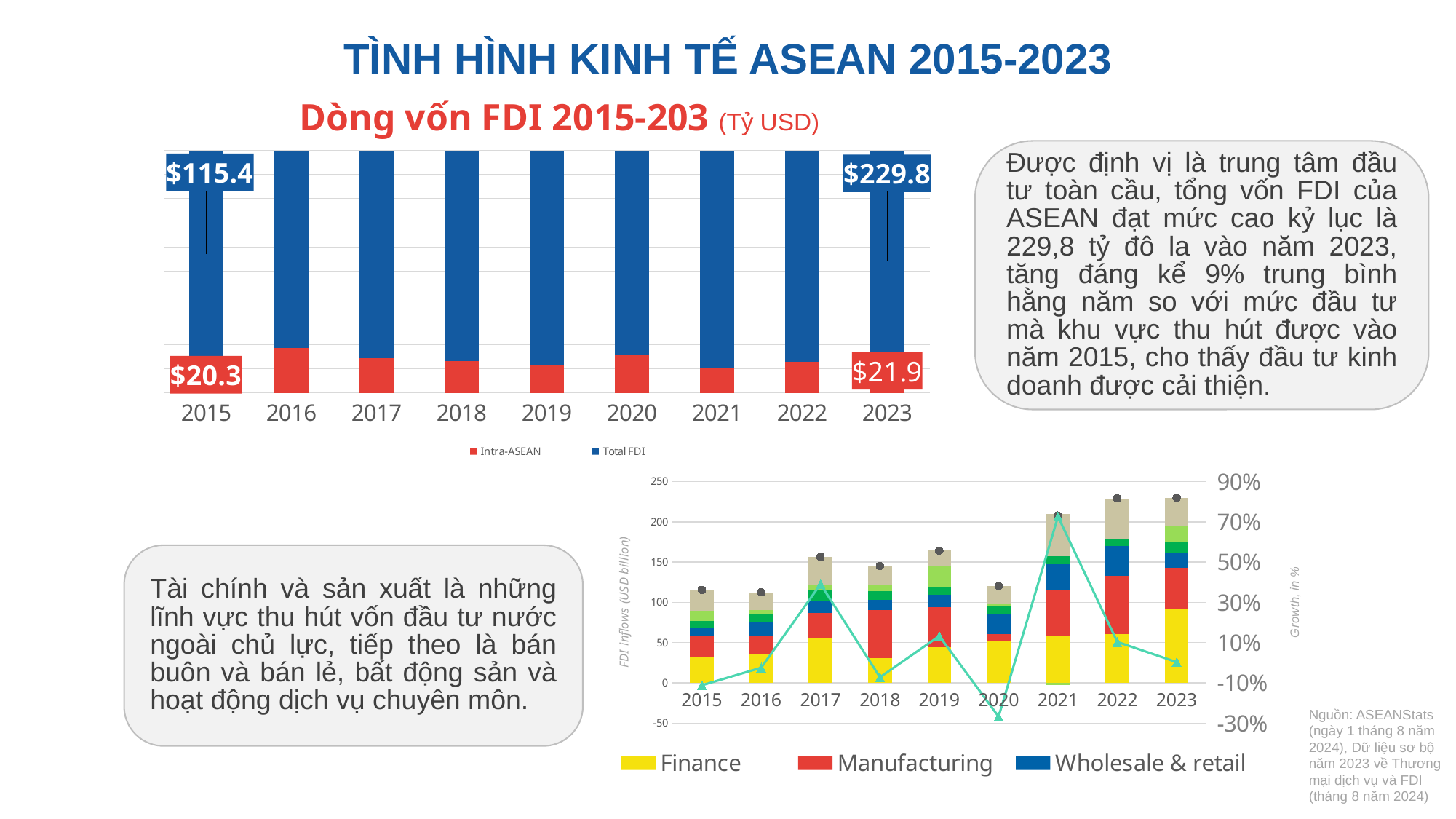
In the top chart 'Dòng vốn FDI 2015-203', what is the Total FDI value for 2015? $115.4 In the top chart 'Dòng vốn FDI 2015-203', which is larger: Intra-ASEAN in 2015 or Intra-ASEAN in 2023? 2023 In the top chart 'Dòng vốn FDI 2015-203', what is the Intra-ASEAN value for 2015? $20.3 In the top chart 'Dòng vốn FDI 2015-203', what is the Intra-ASEAN value for 2023? $21.9 In the top chart 'Dòng vốn FDI 2015-203', what is the Total FDI value for 2023? $229.8 In the bottom chart of FDI inflows by sector, is the total stacked bar for 2023 greater or less than 200? greater In the top chart 'Dòng vốn FDI 2015-203', how many years are shown on the x axis? 9 In the bottom chart of FDI inflows by sector, which three sectors are listed in the legend? Finance, Manufacturing, Wholesale & retail In the top chart 'Dòng vốn FDI 2015-203', how many series does the legend list? 2 In the top chart 'Dòng vốn FDI 2015-203', by how much did Total FDI increase from 2015 to 2023? $114.4 In the top chart 'Dòng vốn FDI 2015-203', which year has the tallest Intra-ASEAN bar? 2016 In the bottom chart of FDI inflows by sector, is the total stacked bar for 2020 greater or less than 150? less